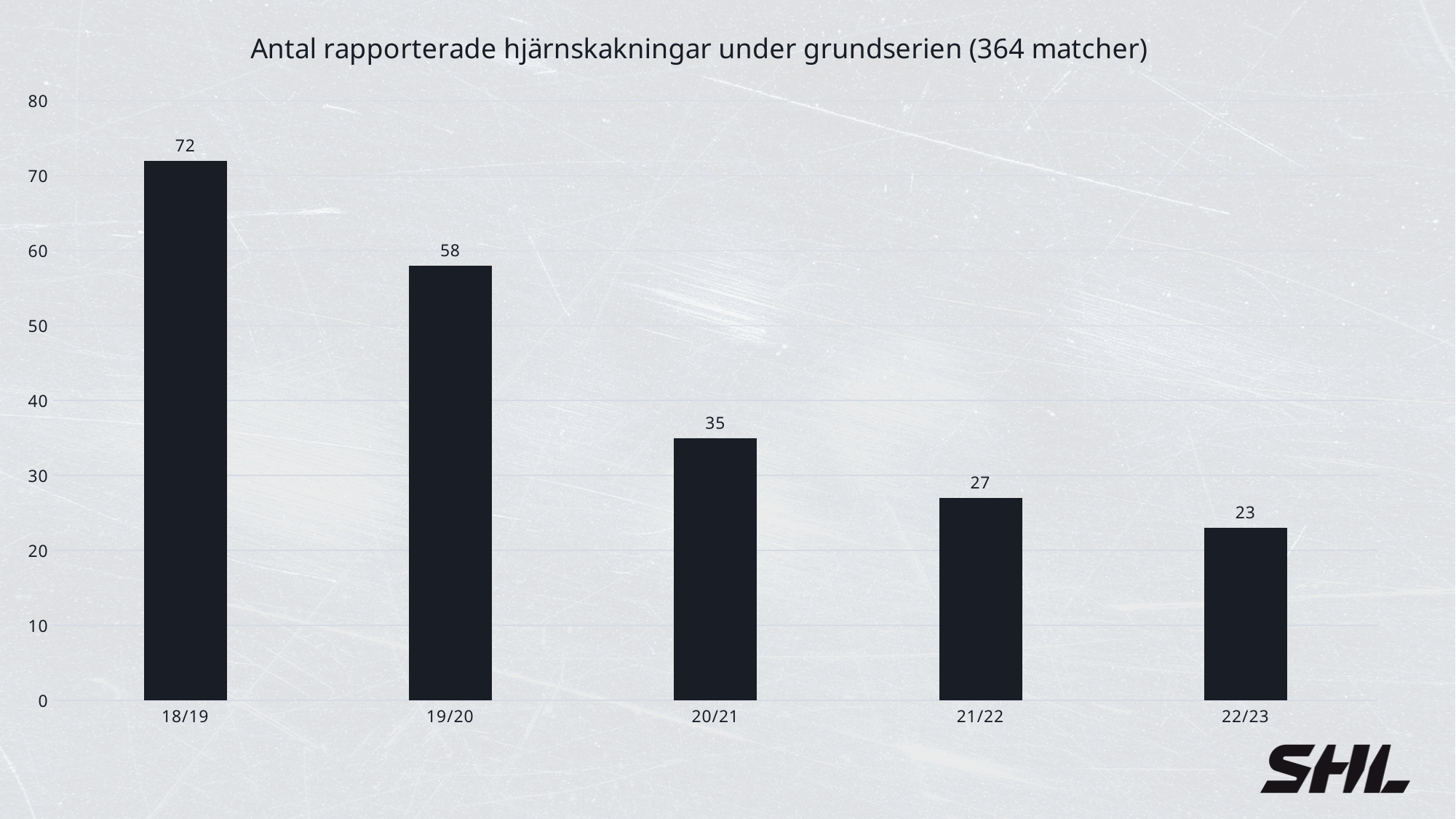
Which season has a larger value, 19/20 or 20/21? 19/20 What is the number of reported concussions for the 18/19 season? 72 Which season has the lowest number of reported concussions? 22/23 Is the value for 21/22 greater or less than 30? less Do the values rise or fall from 18/19 to 22/23? fall What is the value shown for the 22/23 season? 23 What kind of chart is shown on the slide? bar chart Which season has the highest number of reported concussions? 18/19 What is the value shown for the 20/21 season? 35 How many seasons are shown on the x axis? 5 What is the difference between the values for 21/22 and 22/23? 4 What is the difference between the values for 18/19 and 19/20? 14